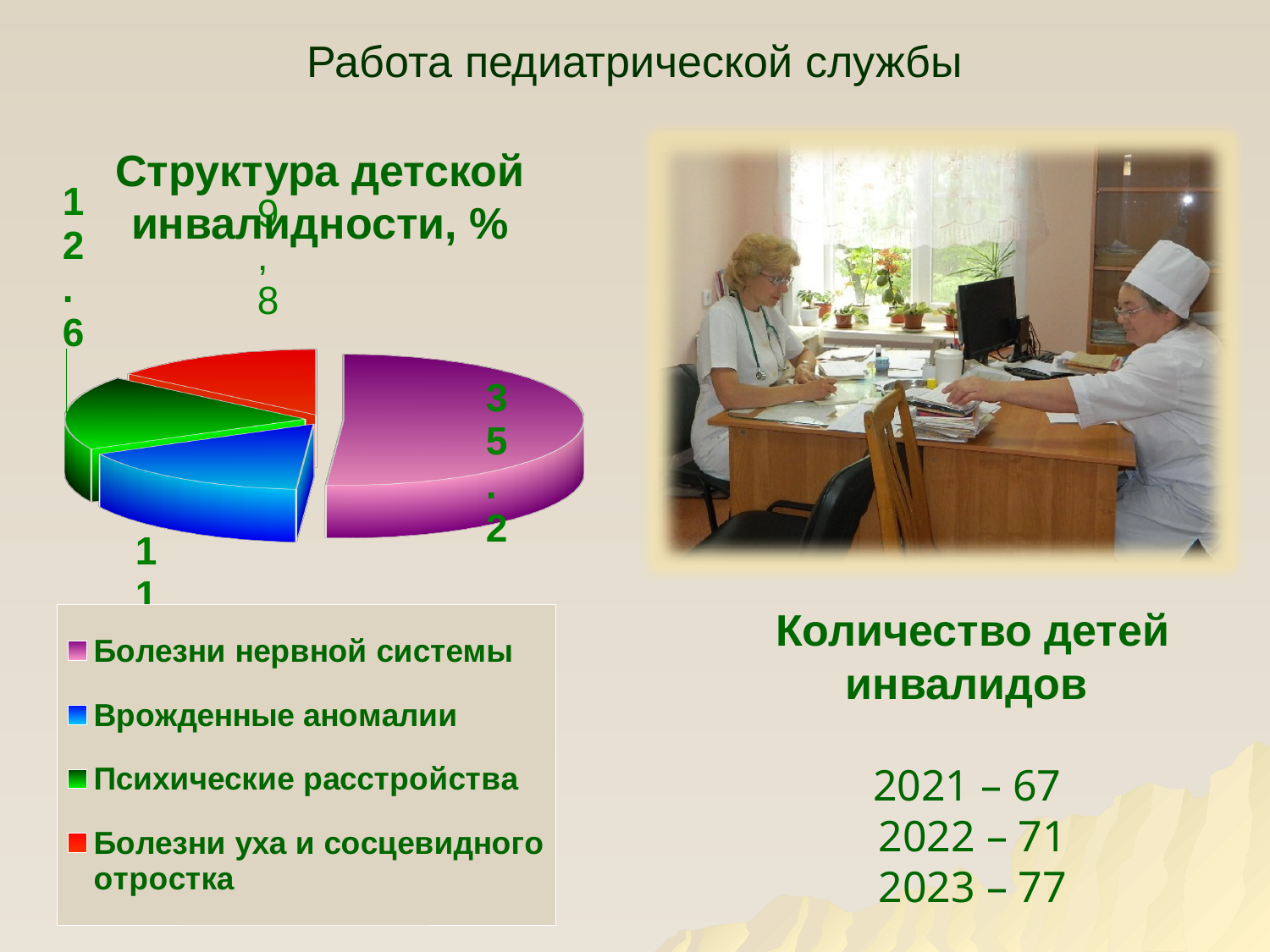
How many categories does the pie chart have? 4 Which is larger: Психические расстройства or Болезни уха и сосцевидного отростка? Психические расстройства Which category has the smallest slice in the pie chart? Болезни уха и сосцевидного отростка Which category has the largest slice in the pie chart? Болезни нервной системы What is the value for Психические расстройства in the pie chart? 12.6 What is the value for Болезни нервной системы in the pie chart? 35.2 How many entries does the chart legend list? 4 What is the difference between the values for Болезни нервной системы and Психические расстройства? 22.6 What kind of chart is shown on the slide? pie chart What is the value for Болезни уха и сосцевидного отростка in the pie chart? 9.8 What colour represents Врожденные аномалии in the pie chart? blue What is the title of the chart on the slide? Структура детской инвалидности, %